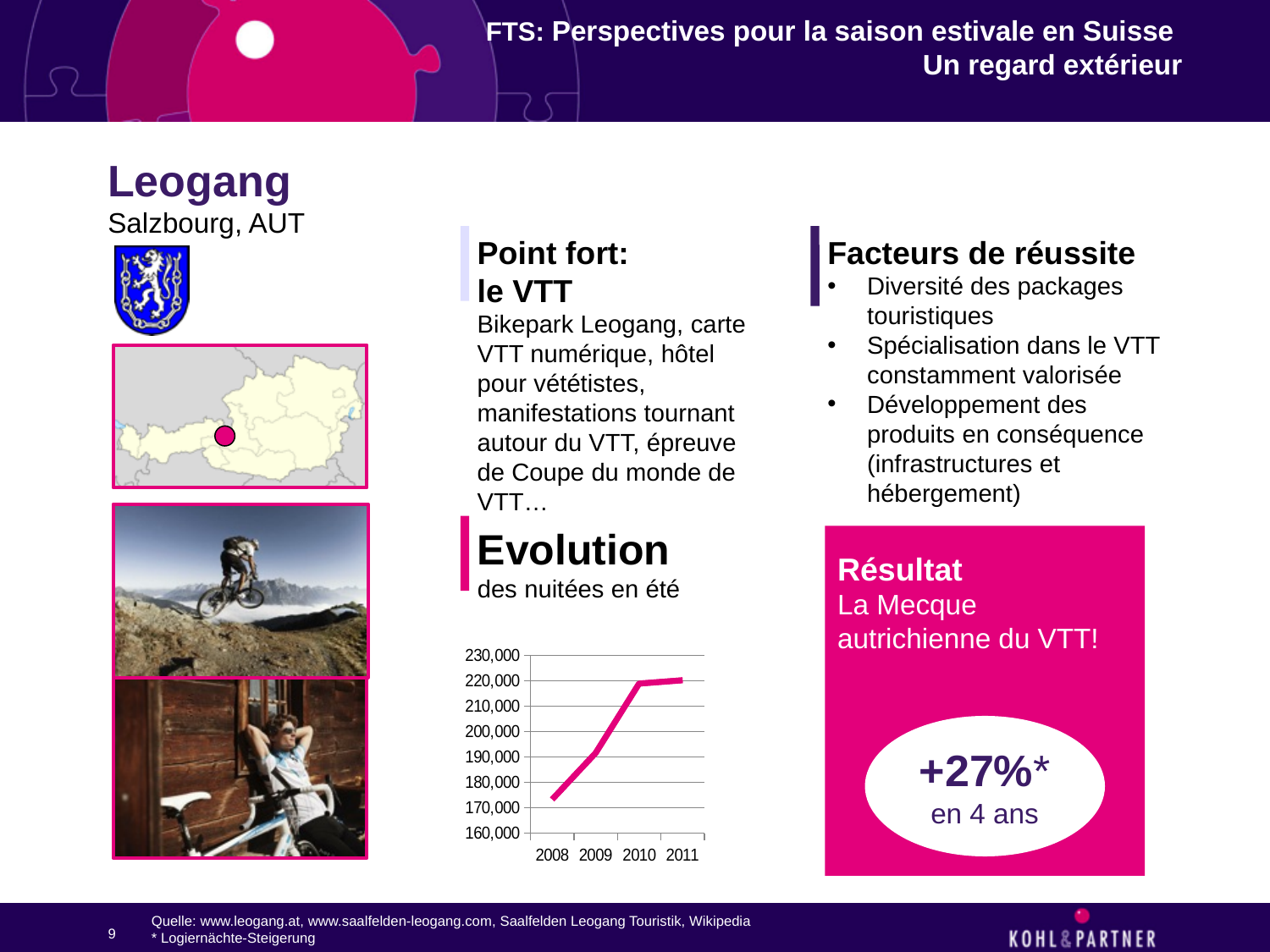
What is the first year shown on the x axis of the chart? 2008 What kind of chart is shown under "Evolution des nuitées en été"? line chart Is the value for 2008 greater or less than 180,000? less Is the value for 2010 greater or less than 210,000? greater Which year has the lowest value in the chart? 2008 Which is larger, the value for 2008 or the value for 2010? 2010 How many years are shown on the x axis of the chart? 4 Is the value for 2009 greater or less than 180,000? greater Do the values in the chart rise or fall from 2008 to 2011? rise What is the highest tick value shown on the y axis of the chart? 230,000